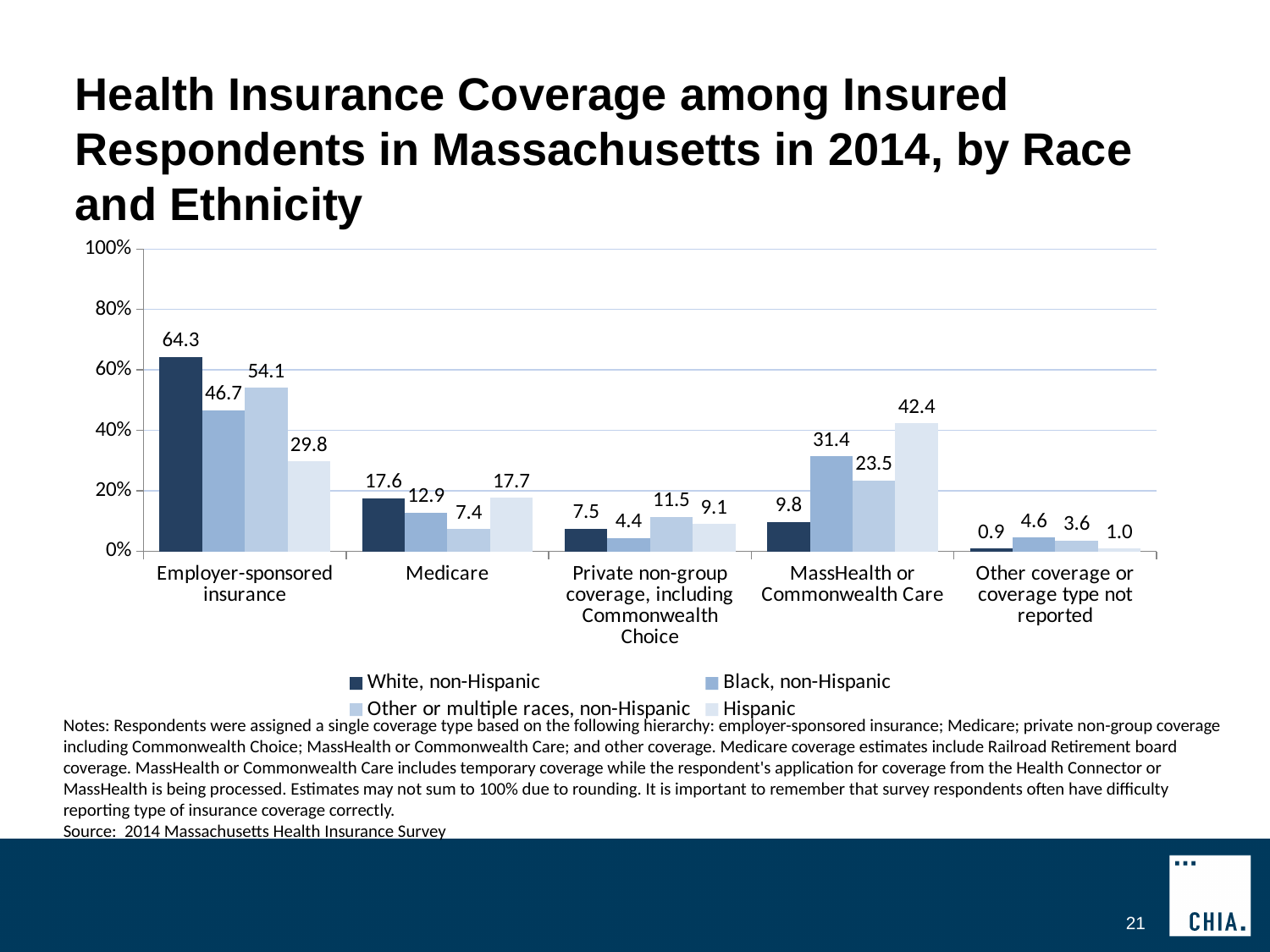
What is the value for Black, non-Hispanic respondents with Medicare coverage? 12.9 Is the value for Black, non-Hispanic respondents with employer-sponsored insurance greater or less than 40%? greater Which race/ethnicity group has the highest value for employer-sponsored insurance? White, non-Hispanic What is the source cited for the chart data? 2014 Massachusetts Health Insurance Survey How many series does the legend list? 4 What is the value for Hispanic respondents with MassHealth or Commonwealth Care coverage? 42.4 What is the value for White, non-Hispanic respondents with employer-sponsored insurance? 64.3 Which is larger for Medicare coverage: the value for White, non-Hispanic or the value for Other or multiple races, non-Hispanic? White, non-Hispanic What is the difference between the Hispanic and White, non-Hispanic values for MassHealth or Commonwealth Care? 32.6 Which race/ethnicity group has the lowest value for private non-group coverage, including Commonwealth Choice? Black, non-Hispanic How many coverage-type categories are shown on the x axis? 5 What kind of chart is shown on the slide? Bar chart